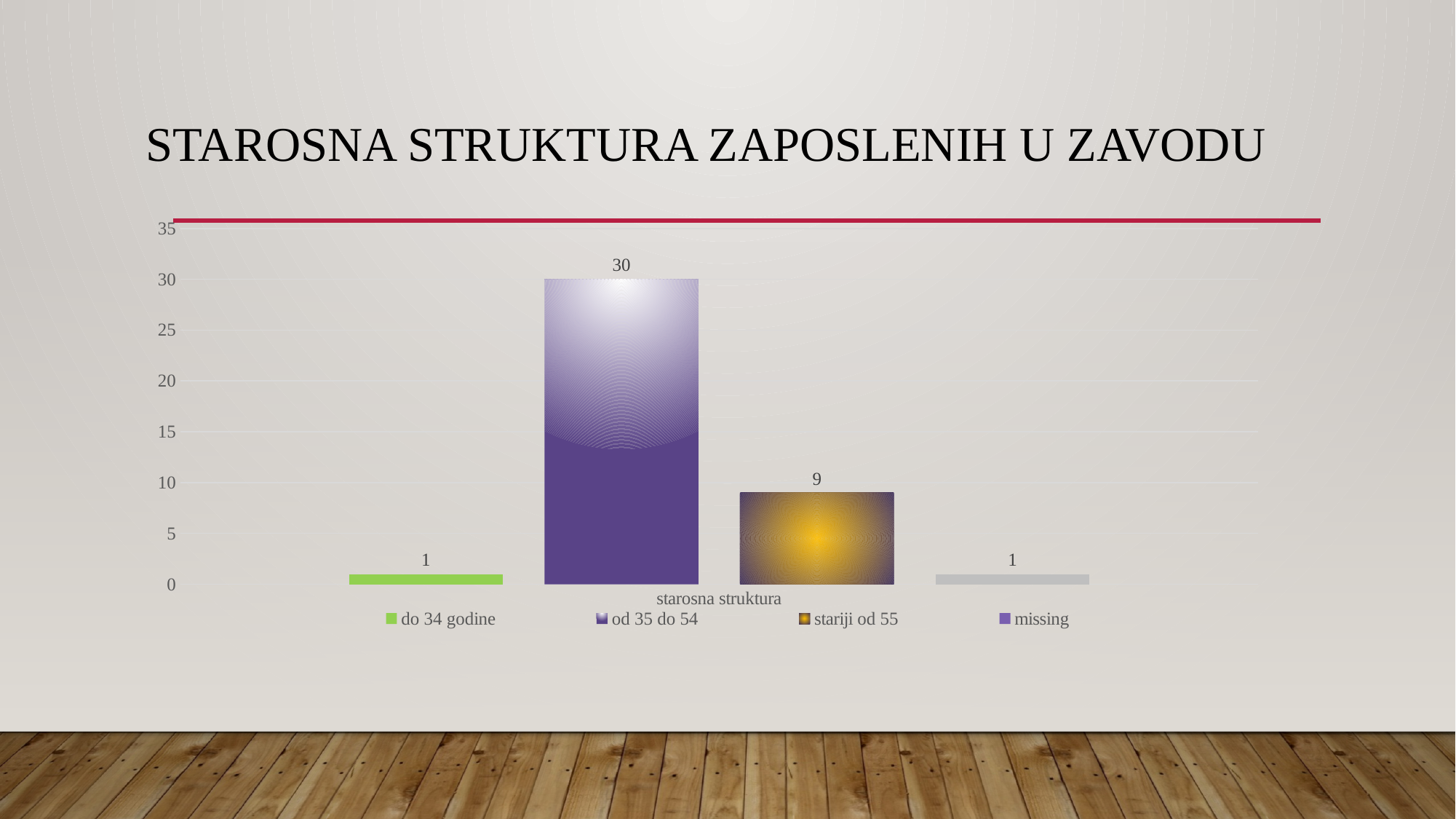
Is the value for 'od 35 do 54' greater or less than 25? greater What is the title of the slide? STAROSNA STRUKTURA ZAPOSLENIH U ZAVODU Which is larger, the value for 'stariji od 55' or the value for 'do 34 godine'? stariji od 55 What is the value for 'od 35 do 54'? 30 What is the value for 'missing'? 1 What is the value for 'do 34 godine'? 1 What is the difference between the values for 'od 35 do 54' and 'stariji od 55'? 21 How many series does the legend list? 4 What is the category label shown on the x axis? starosna struktura Which series has the highest value? od 35 do 54 What kind of chart is shown on the slide? bar chart What is the value for 'stariji od 55'? 9